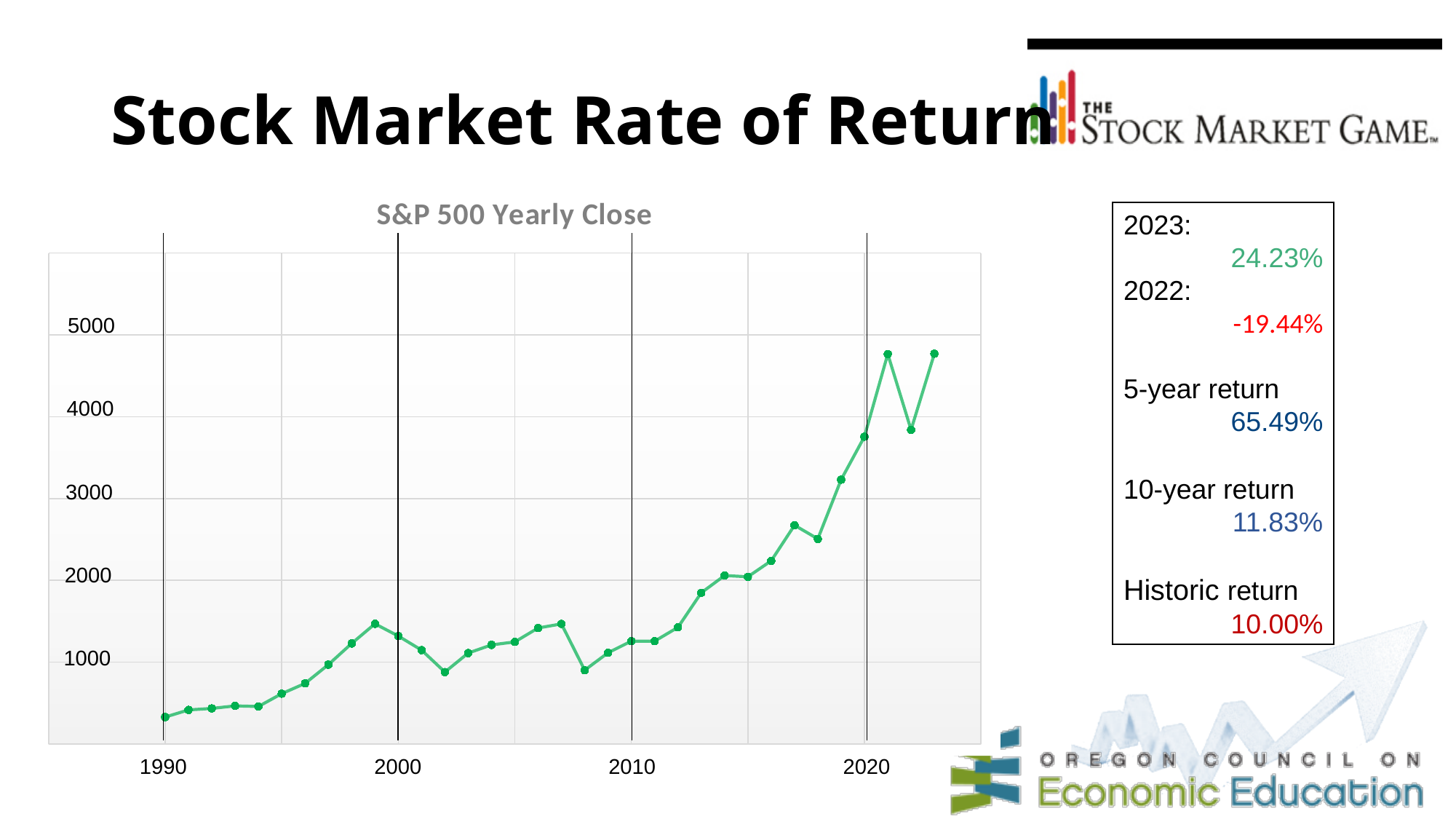
What years are labelled on the x axis of the chart? 1990, 2000, 2010, 2020 Is the value for 2020 greater or less than 4000? less Is the value for 2020 greater or less than 3000? greater What is the title of the chart? S&P 500 Yearly Close Is the value for 2010 greater or less than 2000? less Which year has the lowest S&P 500 yearly close on the chart? 1990 Overall, do the values rise or fall from 1990 to the end of the chart? rise Which is larger, the value for 2020 or the value for 2010? 2020 What kind of chart is shown on the slide? line chart Which is larger, the value for 2000 or the value for 1990? 2000